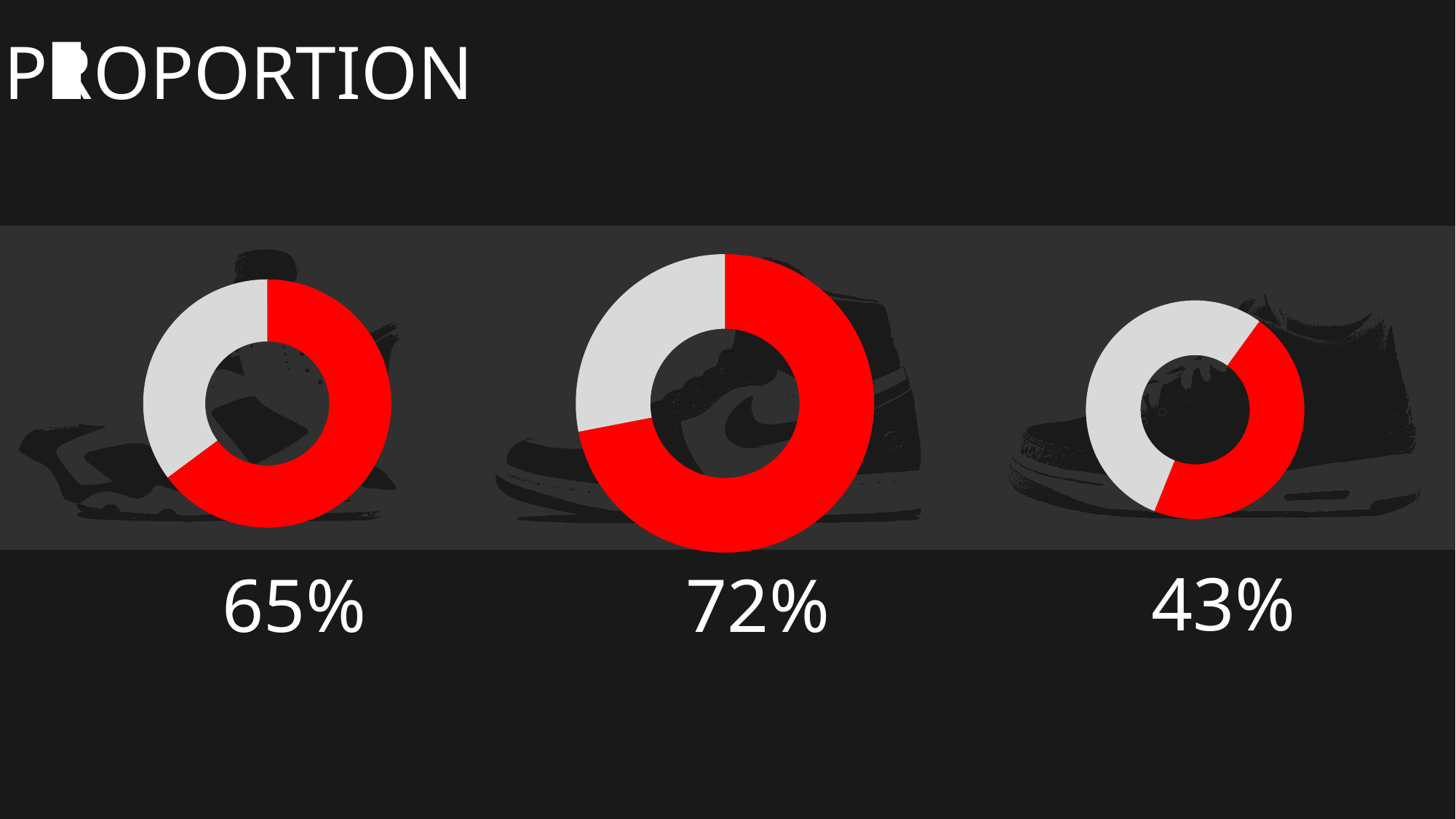
Which of the three donut charts shows the highest percentage? The middle chart (72%) What percentage is shown below the right donut chart? 43% Which of the three donut charts shows the lowest percentage? The right chart (43%) Is the percentage shown for the right chart greater or less than 50%? less What is the difference between the percentage of the left chart and the percentage of the right chart? 22% How many donut charts are on the slide? 3 What percentage is shown below the left donut chart? 65% What is the title of the slide? PROPORTION Is the percentage of the left chart larger or smaller than the percentage of the right chart? larger What percentage is shown below the middle donut chart? 72% What is the difference between the percentage of the middle chart and the percentage of the left chart? 7% What kind of chart is used on this slide? Donut (pie) chart